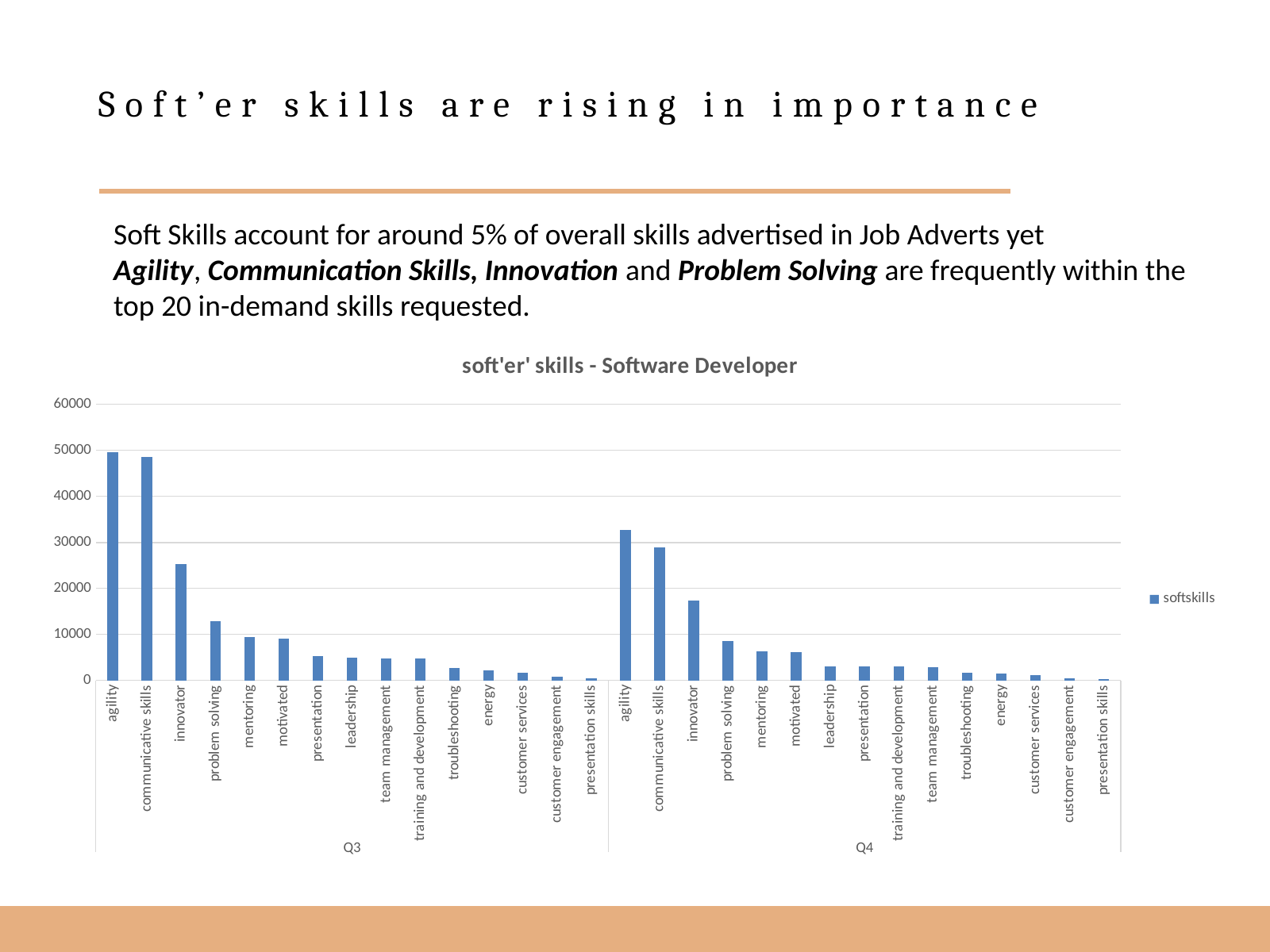
Is the value for problem solving in Q4 greater or less than 10000? less How many skill categories are plotted in the Q3 group? 15 What kind of chart is shown on the slide? bar chart What is the title of the chart? soft'er' skills - Software Developer Which skill has the highest value in the chart? agility (Q3) How many series does the legend list? 1 What is the name of the series shown in the legend? softskills Is the value for innovator in Q3 greater or less than 20000? greater Is the value for agility in Q3 greater or less than 40000? greater Which is larger, the value for agility in Q3 or the value for agility in Q4? agility in Q3 Within the Q3 group, do the values rise or fall from left to right? fall